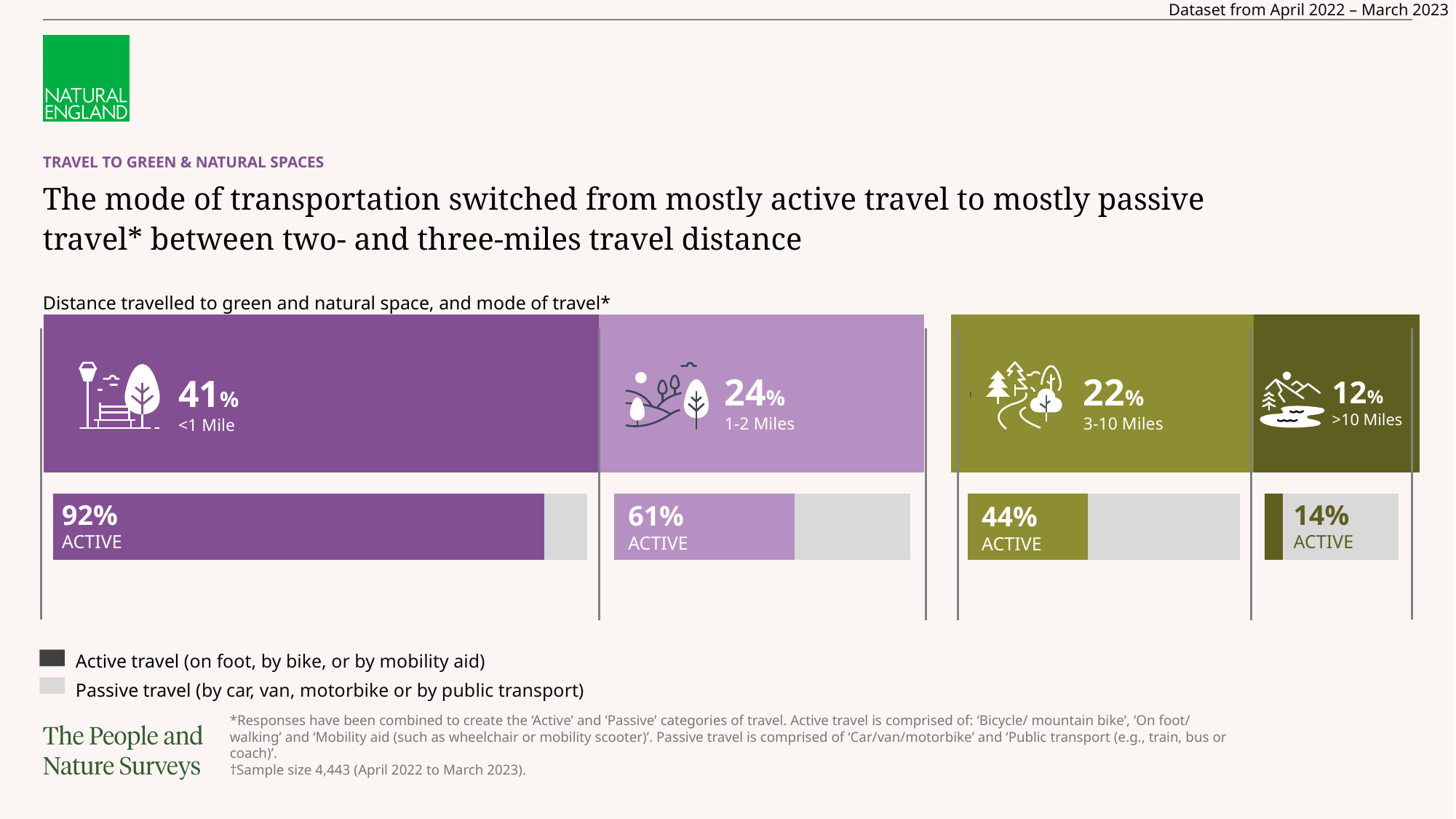
How many travel modes does the legend list? 2 Which distance band has the lowest share of respondents? >10 Miles What percentage of respondents travelled less than 1 mile to green and natural space? 41% What is the difference in active travel share between the <1 Mile and 1-2 Miles bands? 31% What percentage of respondents travelled 3-10 miles? 22% Does the share of active travel rise or fall as travel distance increases? Fall What percentage of trips of more than 10 miles were active travel? 14% What share of trips of 1-2 miles were made by active travel? 61% Which distance band has the highest share of active travel? <1 Mile How many distance bands are shown in the chart? 4 Which has a larger active travel share, the 3-10 Miles band or the >10 Miles band? 3-10 Miles What is the title of the chart? Distance travelled to green and natural space, and mode of travel*